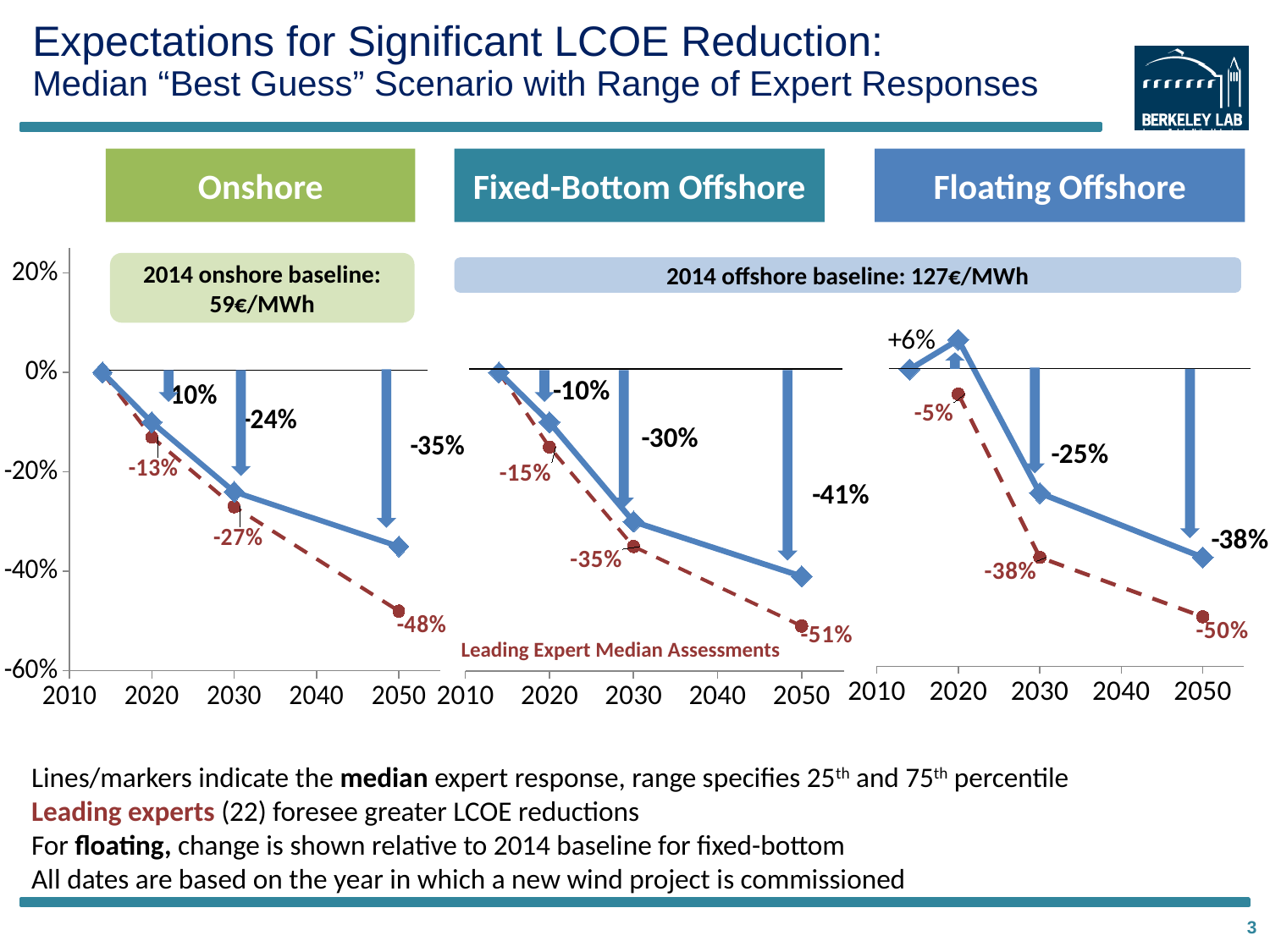
What is the 2014 offshore baseline shown on the slide? 127€/MWh In the Fixed-Bottom Offshore chart, which is lower for 2050: the median response or the leading expert median assessment? Leading expert median assessment In the Floating Offshore chart, what is the leading expert median assessment for 2030? -38% What is the 2014 onshore baseline shown on the slide? 59€/MWh In the Onshore chart, what is the difference between the median 2050 value (-35%) and the leading expert 2050 value (-48%)? 13 percentage points What type of chart is used for the Onshore panel? Line chart In the Floating Offshore chart, does the median line rise or fall between 2020 and 2050? Fall In the Floating Offshore chart, what is the median expected LCOE change for 2020? +6% In the Onshore chart, what is the leading expert median assessment for 2050? -48% In the Fixed-Bottom Offshore chart, what is the median expected LCOE change for 2030? -30% In the Onshore chart, what is the median expected LCOE change for 2050? -35% In the Fixed-Bottom Offshore chart, what is the leading expert median assessment for 2050? -51%